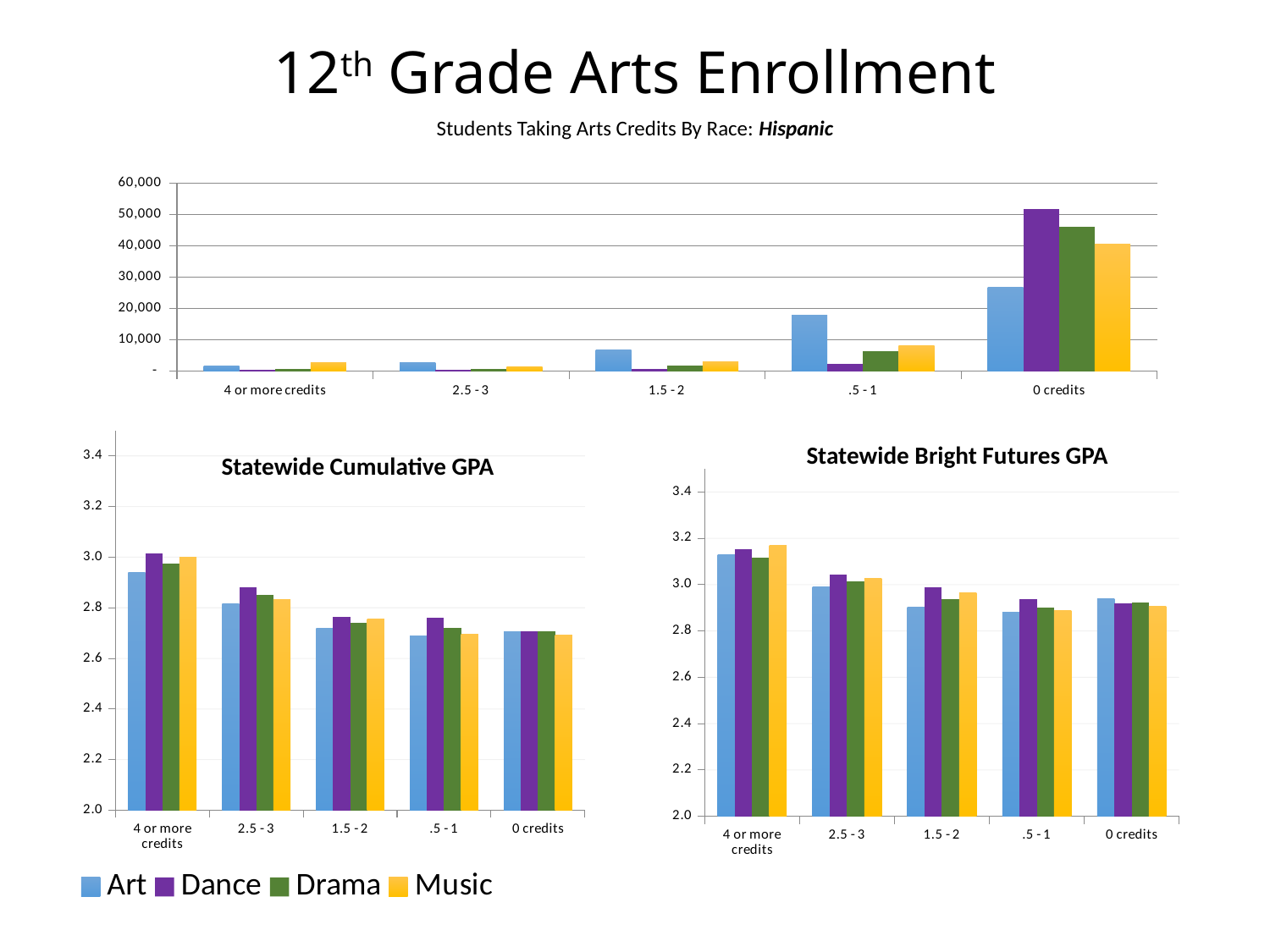
In the top chart, 'Students Taking Arts Credits By Race: Hispanic', is the value for Art in the .5 - 1 category greater or less than 20,000? less How many series does the shared legend at the bottom of the slide list? 4 In the top chart, 'Students Taking Arts Credits By Race: Hispanic', which is larger in the .5 - 1 category: Art or Dance? Art In the top chart, 'Students Taking Arts Credits By Race: Hispanic', which category has the tallest bar overall? 0 credits In the 'Statewide Bright Futures GPA' chart, is the value for Music in the 4 or more credits category greater or less than 3.0? greater What kind of chart is the top chart, 'Students Taking Arts Credits By Race: Hispanic'? bar chart In the 'Statewide Cumulative GPA' chart, do the Art values generally rise or fall moving from 4 or more credits to 0 credits? fall Which series is shown in yellow in the legend? Music How many credit categories are shown on the x axis of the 'Statewide Cumulative GPA' chart? 5 In the 'Statewide Cumulative GPA' chart, is the value for Art in the 4 or more credits category greater or less than 3.0? less In the top chart, 'Students Taking Arts Credits By Race: Hispanic', which series has the highest value in the 0 credits category? Dance